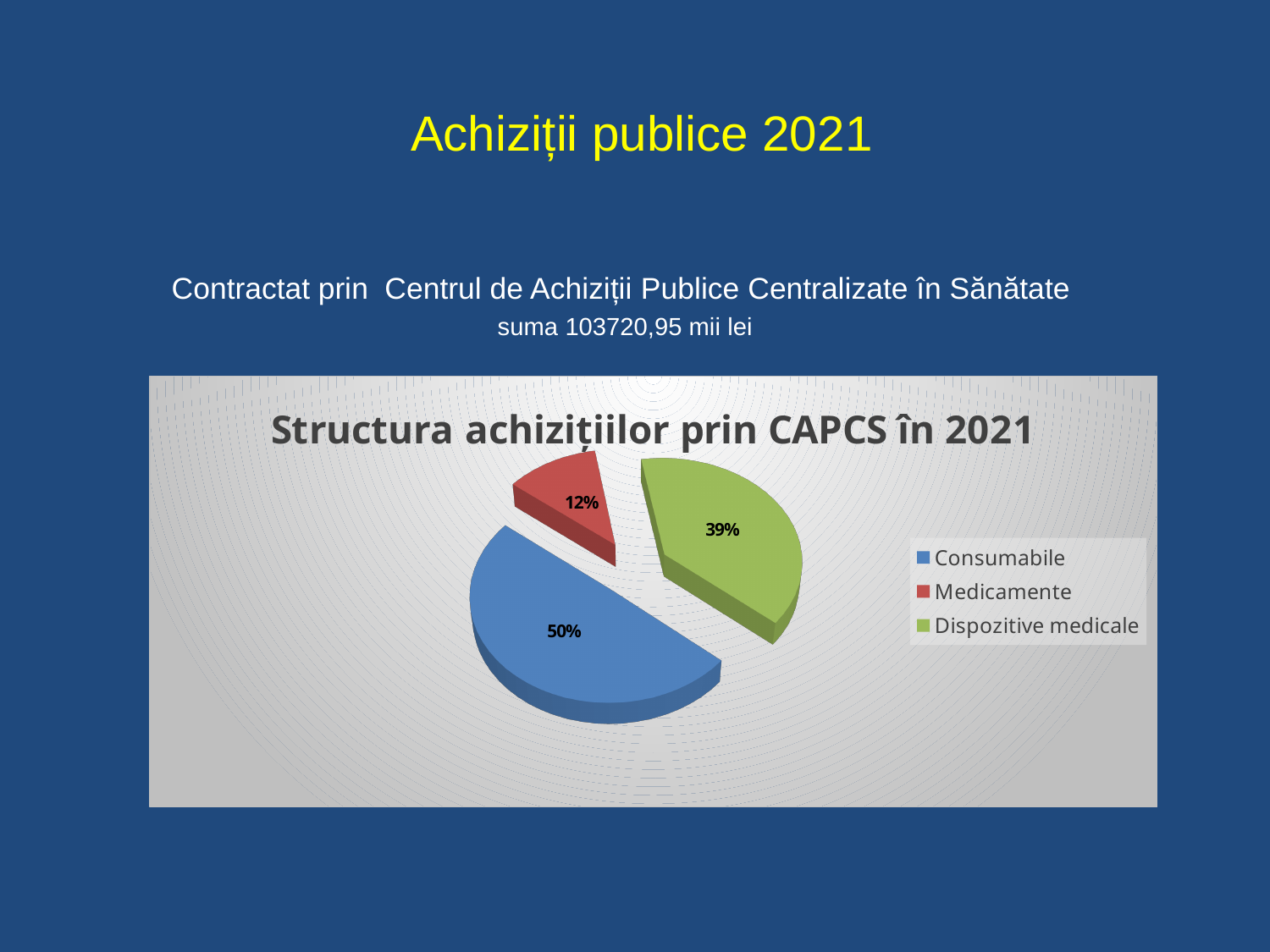
Which category has the smallest slice of the pie? Medicamente Which category has the largest slice of the pie? Consumabile What is the title of the chart? Structura achizițiilor prin CAPCS în 2021 What is the difference in percentage points between Consumabile and Medicamente? 38 How many categories does the pie chart show? 3 What kind of chart is shown on the slide? Pie chart What share of the pie does Medicamente represent? 12% Which is larger, the share for Dispozitive medicale or the share for Medicamente? Dispozitive medicale Which colour represents Dispozitive medicale in the chart? Green What share of the pie does Consumabile represent? 50% What is the difference in percentage points between Dispozitive medicale and Medicamente? 27 What share of the pie does Dispozitive medicale represent? 39%